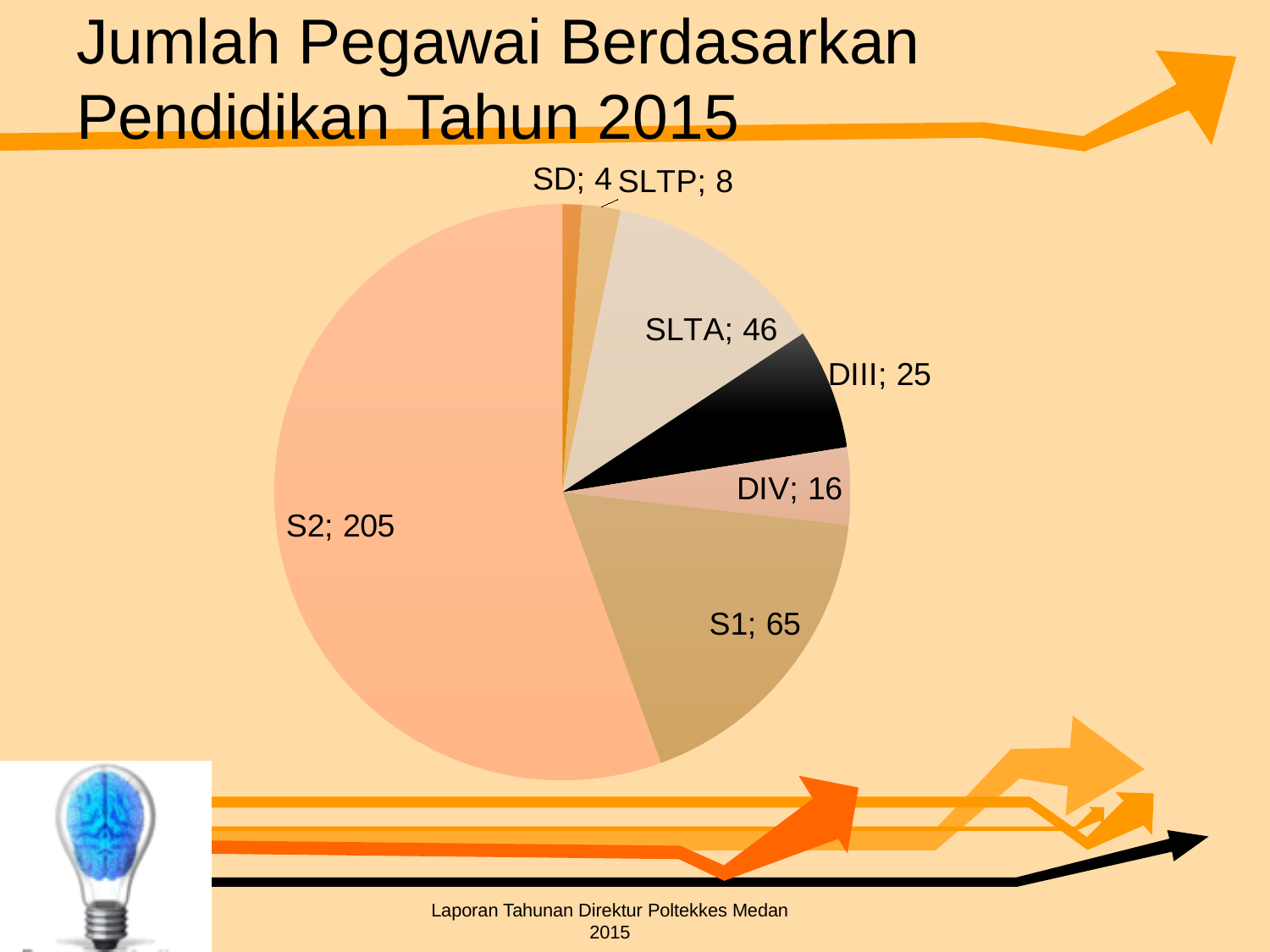
What is the difference between the values for S1 and DIII? 40 What is the total of all the values in the pie chart? 369 Which education category has the highest number of employees? S2 What is the value for DIV? 16 What is the title of the chart on the slide? Jumlah Pegawai Berdasarkan Pendidikan Tahun 2015 What share of the pie does S2 represent? 55.6% What is the value for SLTA? 46 Which is larger, the value for SLTA or the value for DIII? SLTA What kind of chart is shown on the slide? Pie chart How many categories are shown in the pie chart? 7 Which education category has the lowest number of employees? SD What is the value for S2? 205